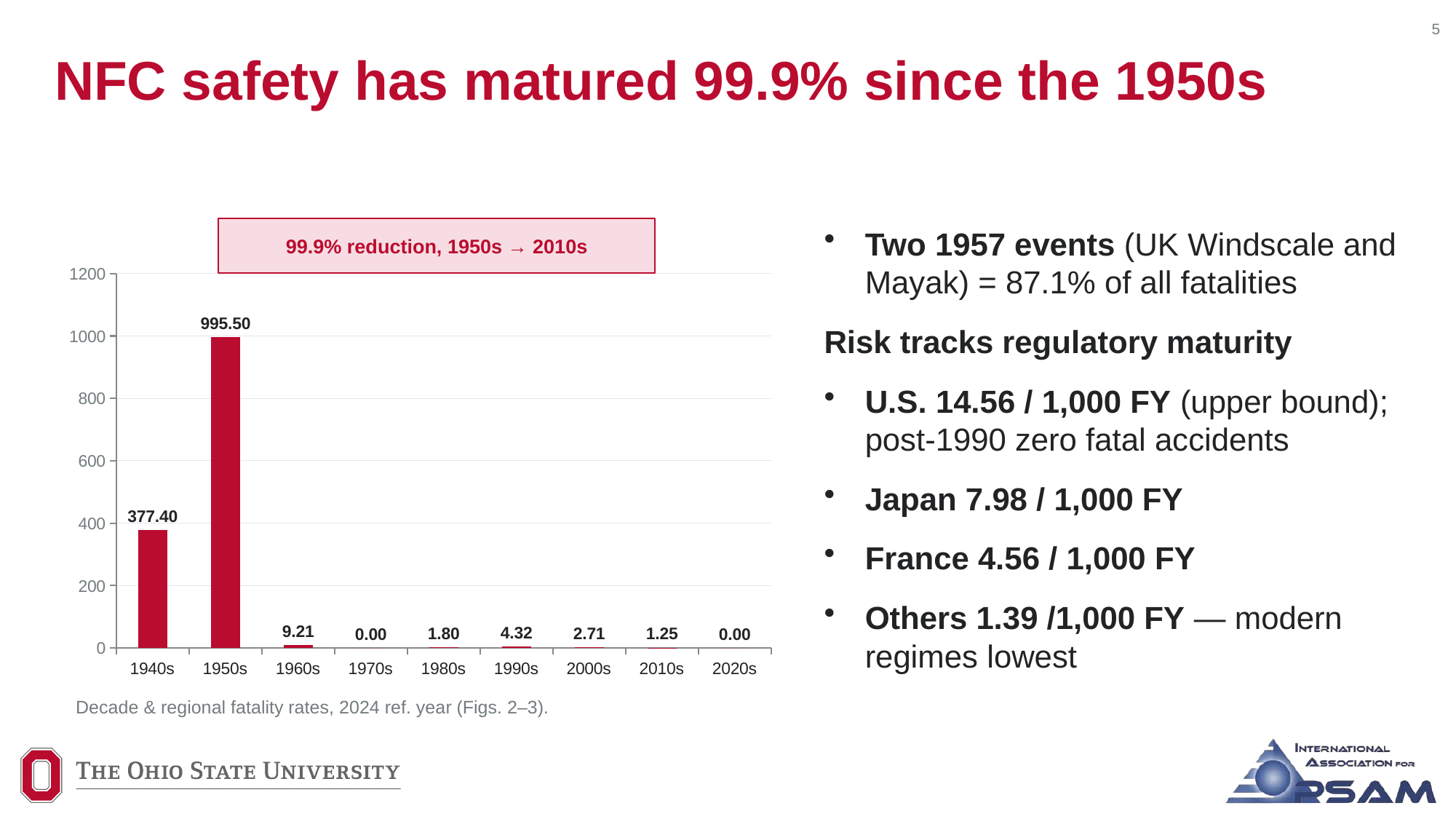
What is the value for the 2010s? 1.25 What is the value for the 1940s? 377.40 What is the value for the 1990s? 4.32 How many decades are shown on the x axis? 9 What is the value for the 1950s? 995.50 What is the difference between the 1950s and 1940s values? 618.10 What kind of chart is shown? bar chart Which decade has the highest value? 1950s What is the value for the 1960s? 9.21 Is the value for the 1940s greater or less than 400? less Which is larger, the value for the 1960s or the 1990s? 1960s What does the annotation box above the chart say? 99.9% reduction, 1950s → 2010s